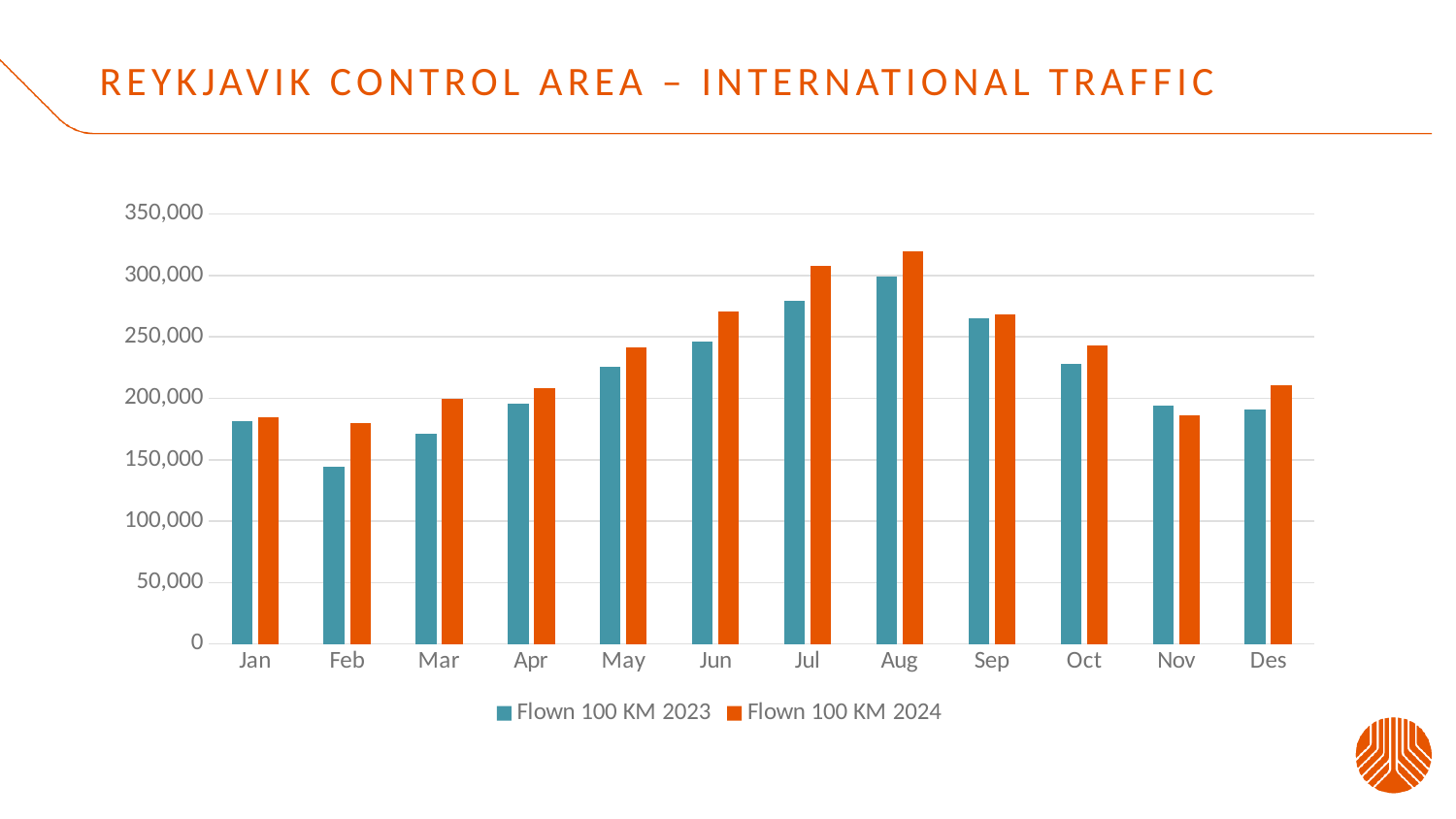
Which month has the lowest value for Flown 100 KM 2023? Feb Is the value for Flown 100 KM 2023 in Feb greater or less than 150,000? less Is the value for Flown 100 KM 2023 in Mar greater or less than 200,000? less Is the value for Flown 100 KM 2024 in Jun greater or less than 250,000? greater Do the Flown 100 KM 2024 values rise or fall from Jan to Aug? rise In Feb, which series has the larger value, Flown 100 KM 2023 or Flown 100 KM 2024? Flown 100 KM 2024 How many months are shown on the x axis? 12 How many series does the legend list? 2 Which month has the highest value for Flown 100 KM 2024? Aug What kind of chart is shown on the slide? Bar chart What is the title of the chart on the slide? Reykjavik Control Area – International Traffic